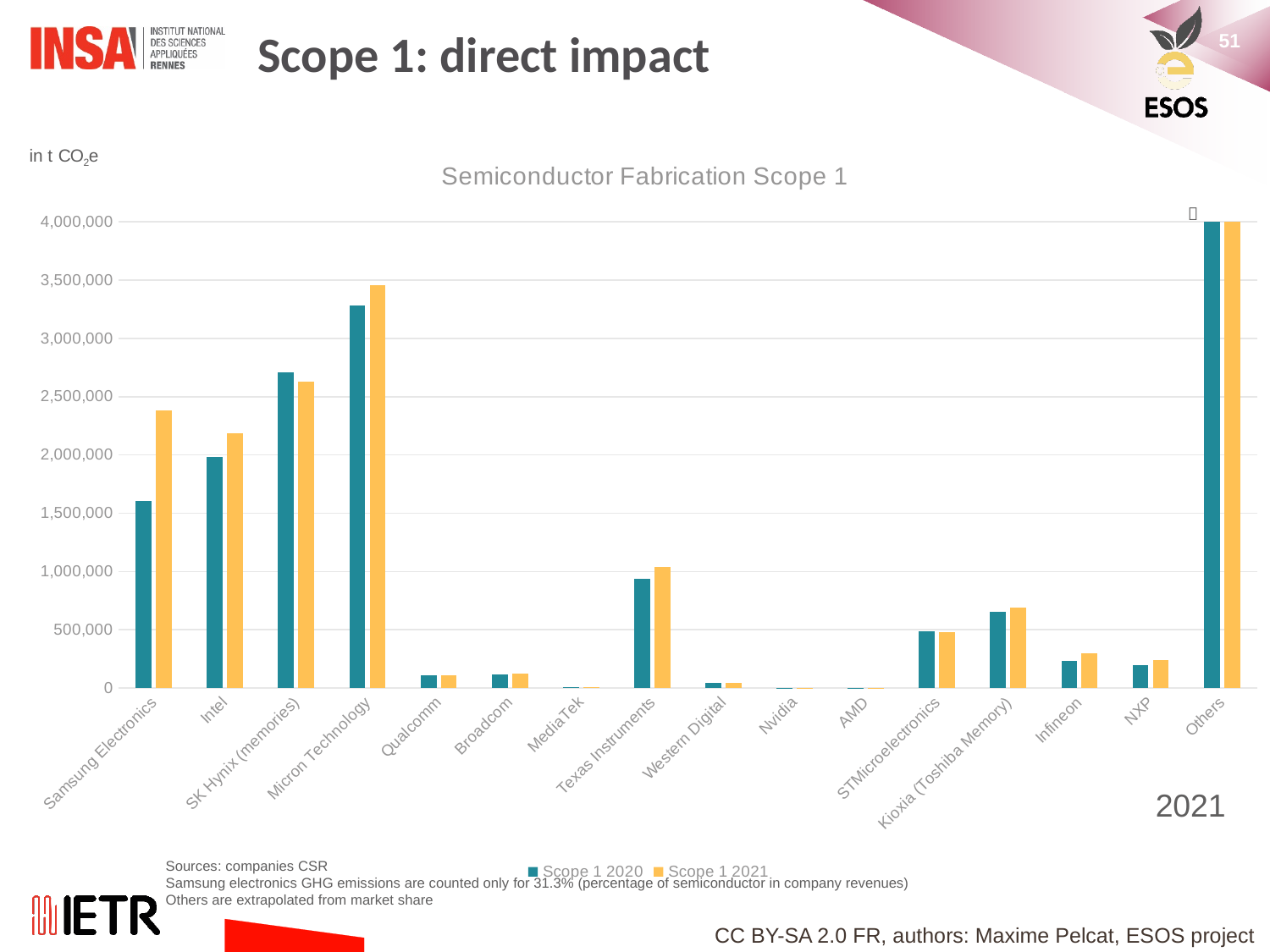
What are the two series named in the chart legend? Scope 1 2020 and Scope 1 2021 How many categories are shown on the x axis of the chart? 16 What type of chart is shown on the slide? bar chart Which category has the tallest bars in the chart? Others Is the Scope 1 2021 value for Samsung Electronics greater or less than 2,000,000? greater Among the named companies (excluding Others), which has the highest Scope 1 2021 value? Micron Technology Is the Scope 1 2020 value for Samsung Electronics greater or less than 1,500,000? greater For SK Hynix (memories), which is larger: the Scope 1 2020 value or the Scope 1 2021 value? Scope 1 2020 What is the title of the chart? Semiconductor Fabrication Scope 1 Is the Scope 1 2020 value for Micron Technology greater or less than 3,000,000? greater How many series does the legend of the chart list? 2